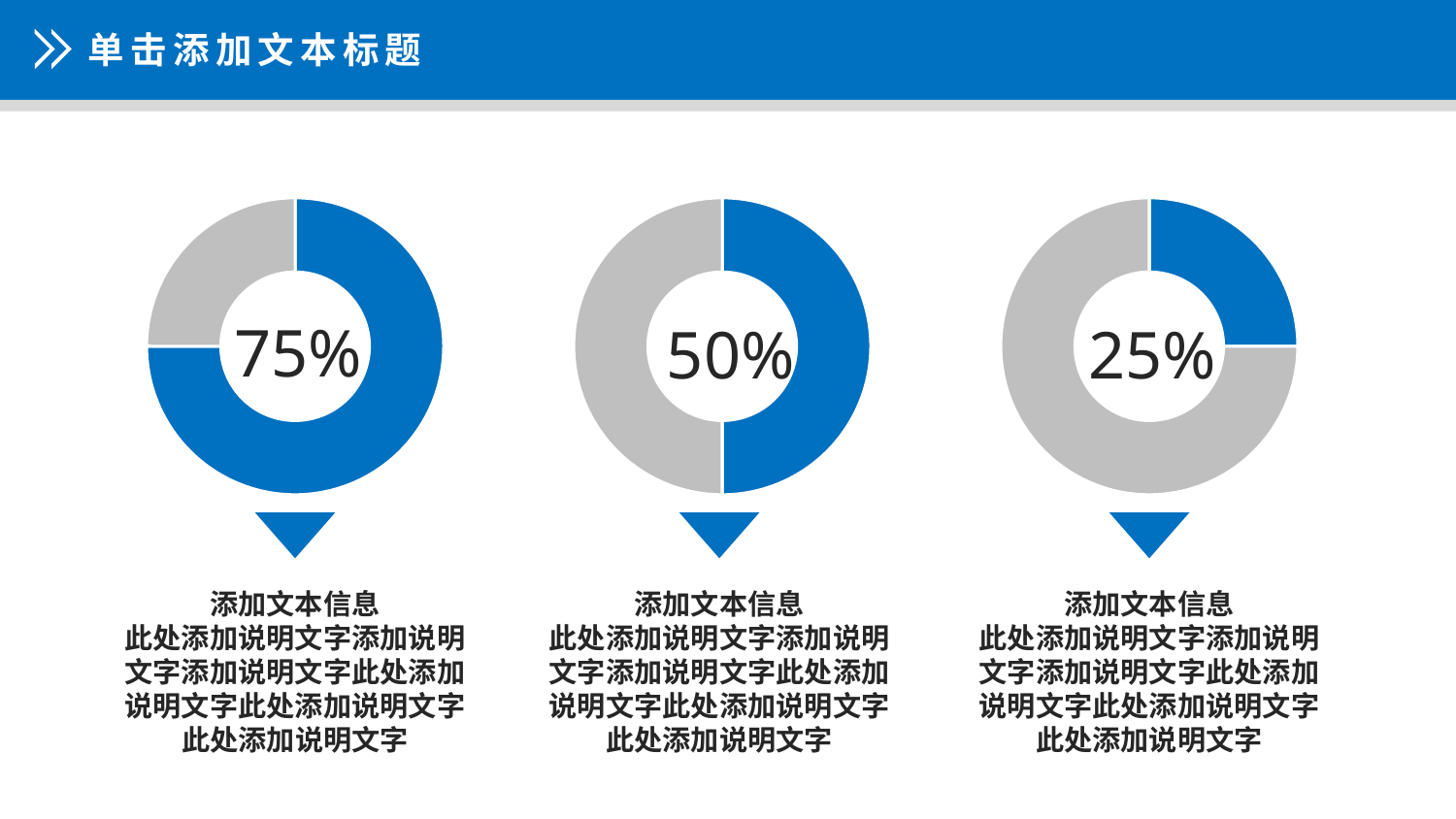
What percentage is shown in the centre of the right donut chart? 25% What kind of chart is used three times on this slide? Donut chart How many donut charts are on the slide? 3 What percentage is shown in the centre of the left donut chart? 75% In the middle donut chart, what share of the ring is blue? 50% What percentage is shown in the centre of the middle donut chart? 50% Which donut chart shows the lowest percentage: left, middle or right? Right Which donut chart shows the highest percentage: left, middle or right? Left What is the difference between the percentage in the left donut chart and the percentage in the right donut chart? 50% What colour is the filled (highlighted) portion of each donut chart? Blue Do the percentages in the donut charts rise or fall from left to right across the slide? Fall Which is larger, the percentage in the middle donut chart or the percentage in the right donut chart? Middle donut chart